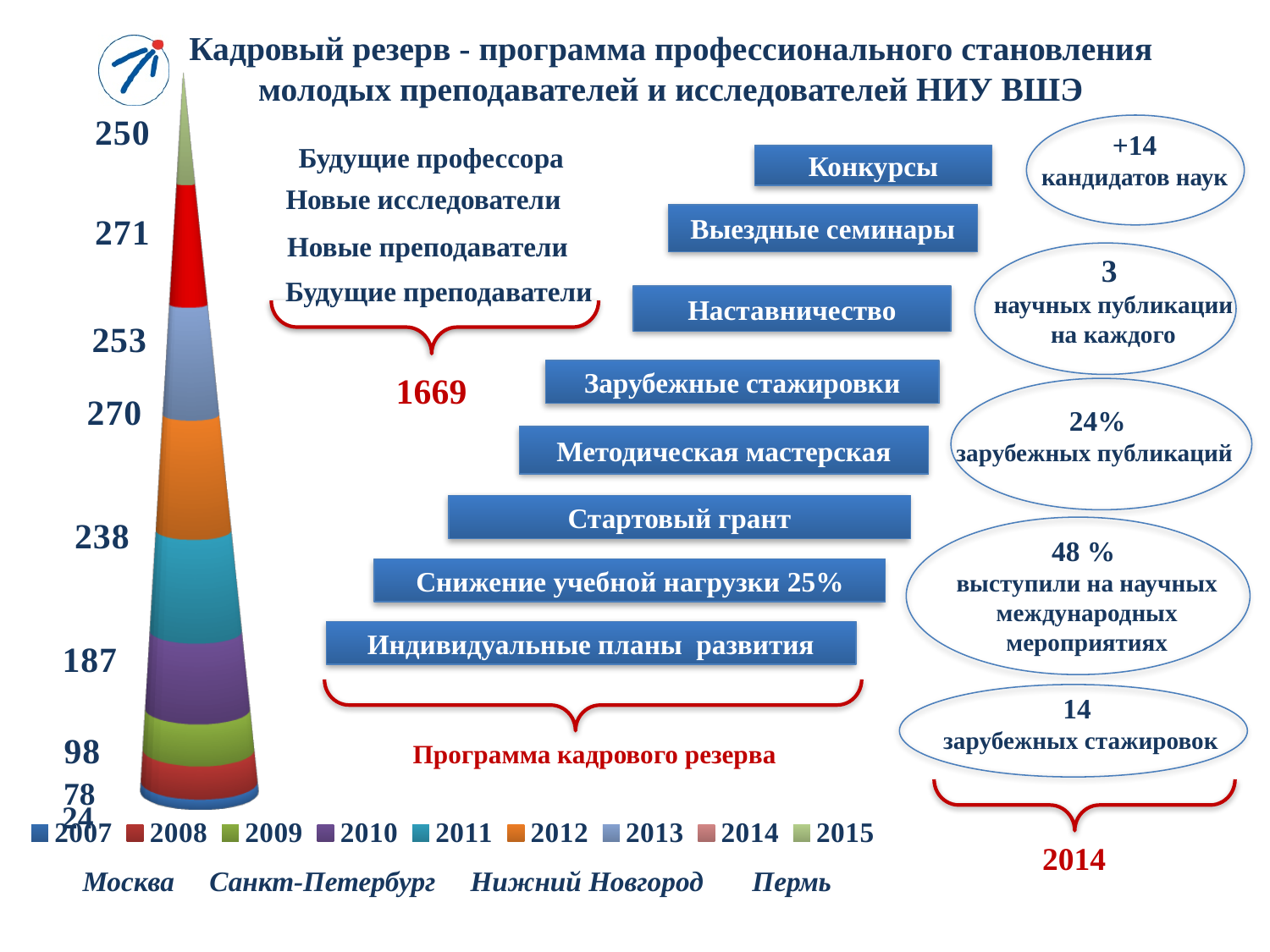
What is the total of all segments in the stacked chart? 1669 What is the value for 2012 in the stacked chart? 270 How many years does the legend of the stacked chart list? 9 Which year has the highest value in the stacked chart? 2014 Which year has the lowest value in the stacked chart? 2007 Which is larger, the value for 2009 or the value for 2008? 2009 What is the value for 2010 in the stacked chart? 187 What is the difference between the values for 2011 and 2010? 51 Do the values rise or fall from 2007 to 2012? rise What colour is the 2012 segment in the stacked chart? orange What is the value for 2015 in the stacked chart? 250 What is the value for 2007 in the stacked chart? 24